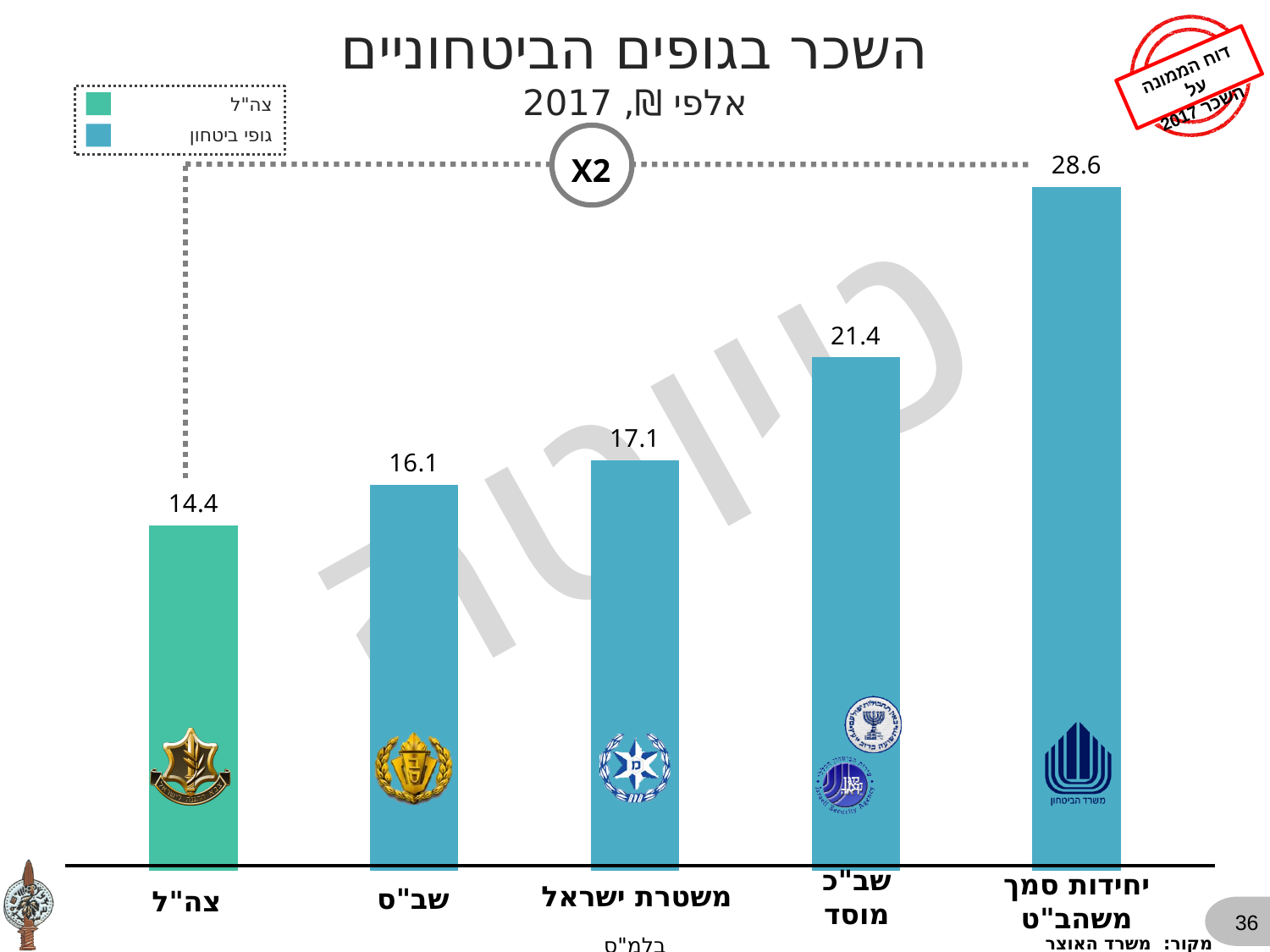
What is the value for משטרת ישראל? 17.1 What is the difference between the values for יחידות סמך משהב"ט and צה"ל? 14.2 What is the value for יחידות סמך משהב"ט? 28.6 What is the difference between the values for שב"כ מוסד and שב"ס? 5.3 How many categories are shown in the chart? 5 How many entries does the legend list? 2 What is the value for שב"כ מוסד? 21.4 Which category has the lowest value? צה"ל Which is larger, the value for שב"ס or the value for משטרת ישראל? משטרת ישראל Which category has the highest value? יחידות סמך משהב"ט What kind of chart is shown on the slide? bar chart What is the value for צה"ל in the chart? 14.4